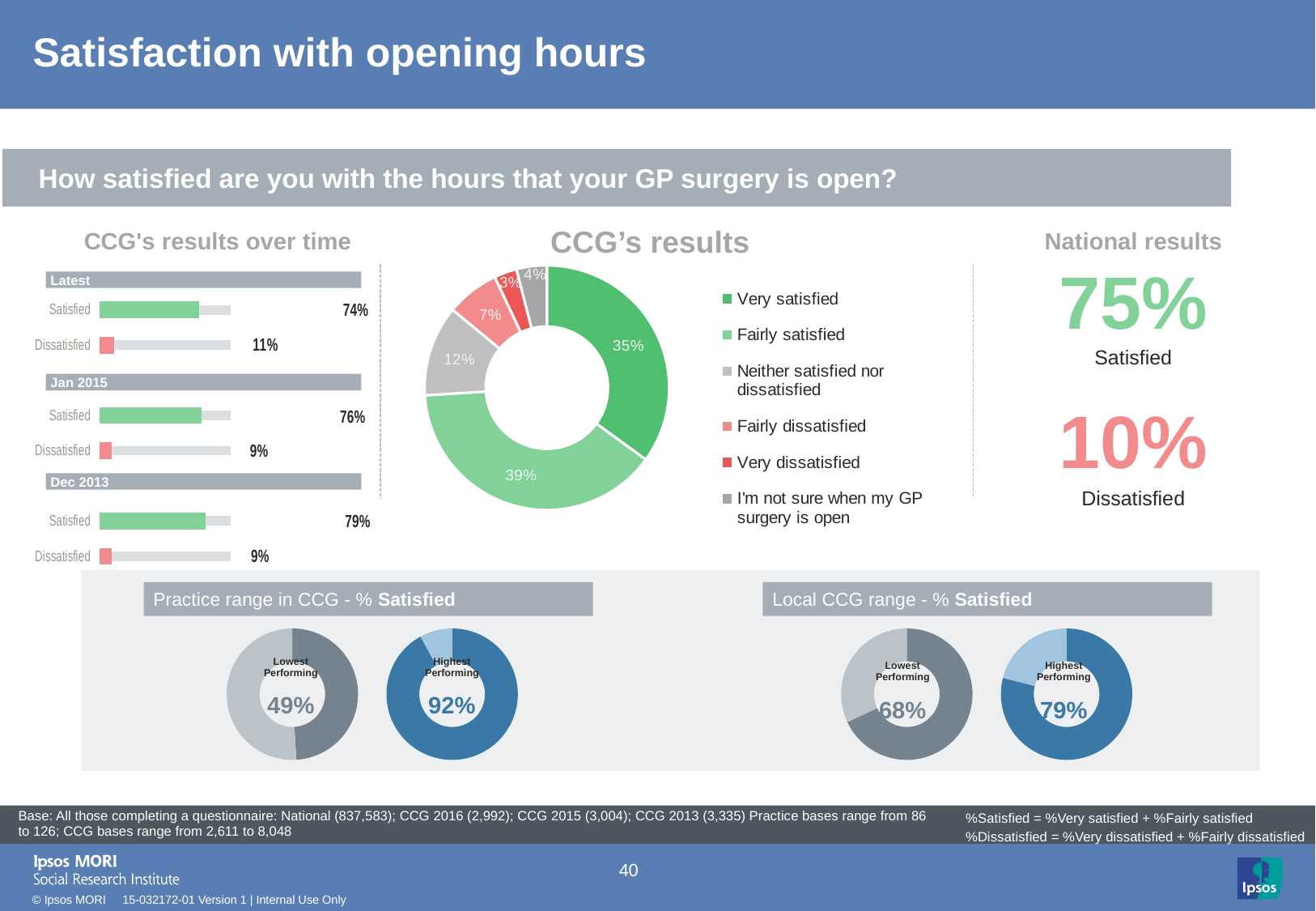
In the 'CCG's results over time' chart, what is the Dissatisfied value for Jan 2015? 9% In the 'CCG's results' donut chart, which category has the smallest share? Very dissatisfied How many entries does the legend of the 'CCG's results' donut chart list? 6 In the 'Practice range in CCG - % Satisfied' charts, what is the Highest Performing value? 92% In the 'CCG's results over time' chart, does the Satisfied value rise or fall from Dec 2013 to Latest? Fall In the 'CCG's results' donut chart, what percentage were very satisfied? 35% In the 'CCG's results' donut chart, which category has the largest share? Fairly satisfied In the 'CCG's results' donut chart, what percentage were fairly satisfied? 39% In the 'CCG's results over time' chart, what is the Satisfied value for Latest? 74% What kind of chart is the 'CCG's results' chart? Donut (pie) chart In the 'Local CCG range - % Satisfied' charts, what is the difference between the Highest Performing and Lowest Performing values? 11 percentage points In the 'CCG's results over time' chart, what is the difference between the Satisfied values for Dec 2013 and Latest? 5 percentage points